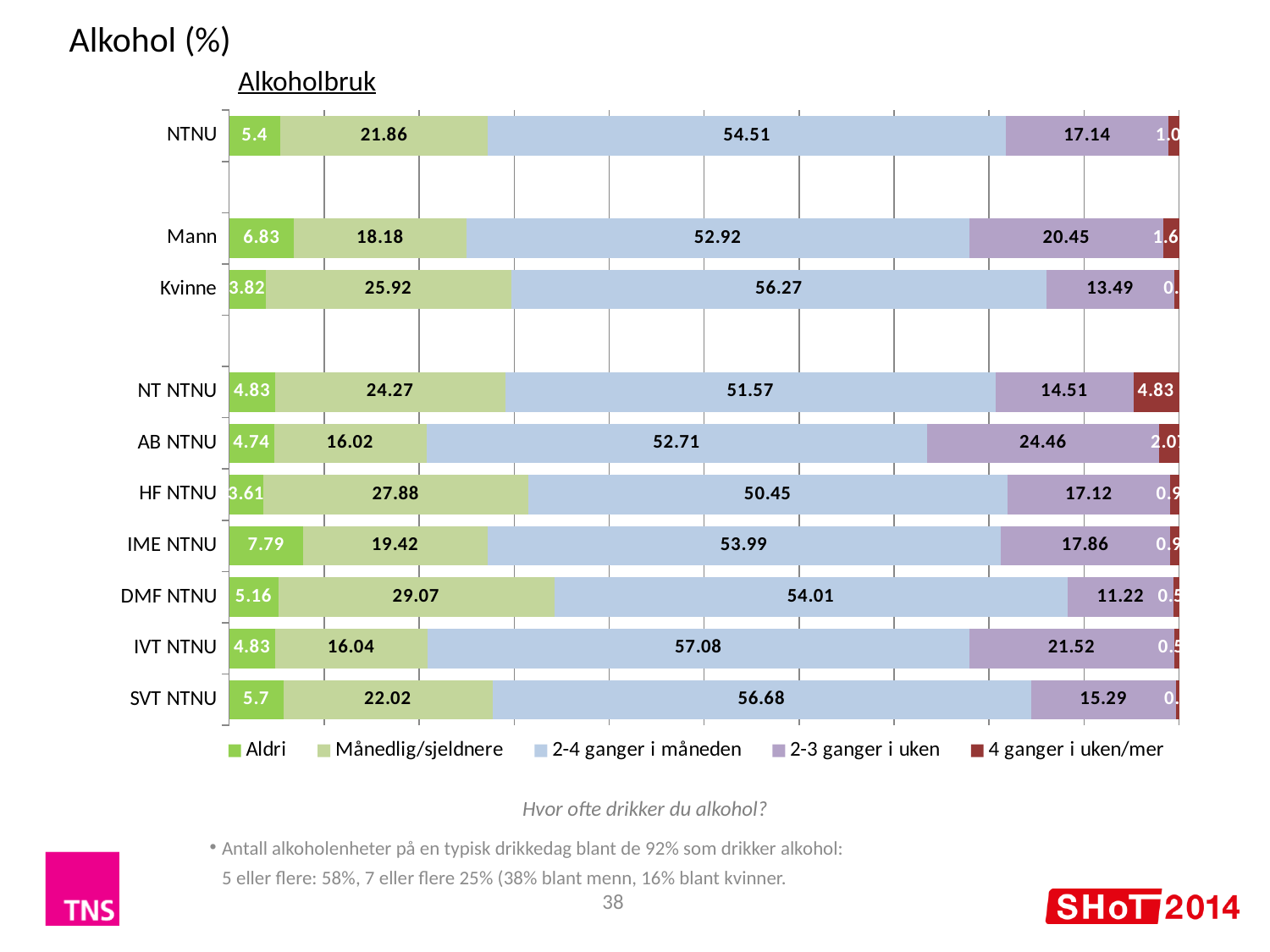
What is the title of the chart on the slide? Alkoholbruk What is the difference between the '2-3 ganger i uken' values for Mann and Kvinne? 6.96 What is the '2-3 ganger i uken' value for AB NTNU? 24.46 Which category has the highest 'Månedlig/sjeldnere' value? DMF NTNU How many categories (bars) are shown in the Alkoholbruk chart? 10 How many series does the legend of the Alkoholbruk chart list? 5 What is the 'Aldri' value for IME NTNU? 7.79 What is the value of '2-4 ganger i måneden' for NTNU? 54.51 Which category has the lowest '2-3 ganger i uken' value? DMF NTNU What is the 'Månedlig/sjeldnere' value for Kvinne? 25.92 What type of chart is shown on the slide? stacked bar chart Which has a larger '2-4 ganger i måneden' value, IVT NTNU or HF NTNU? IVT NTNU